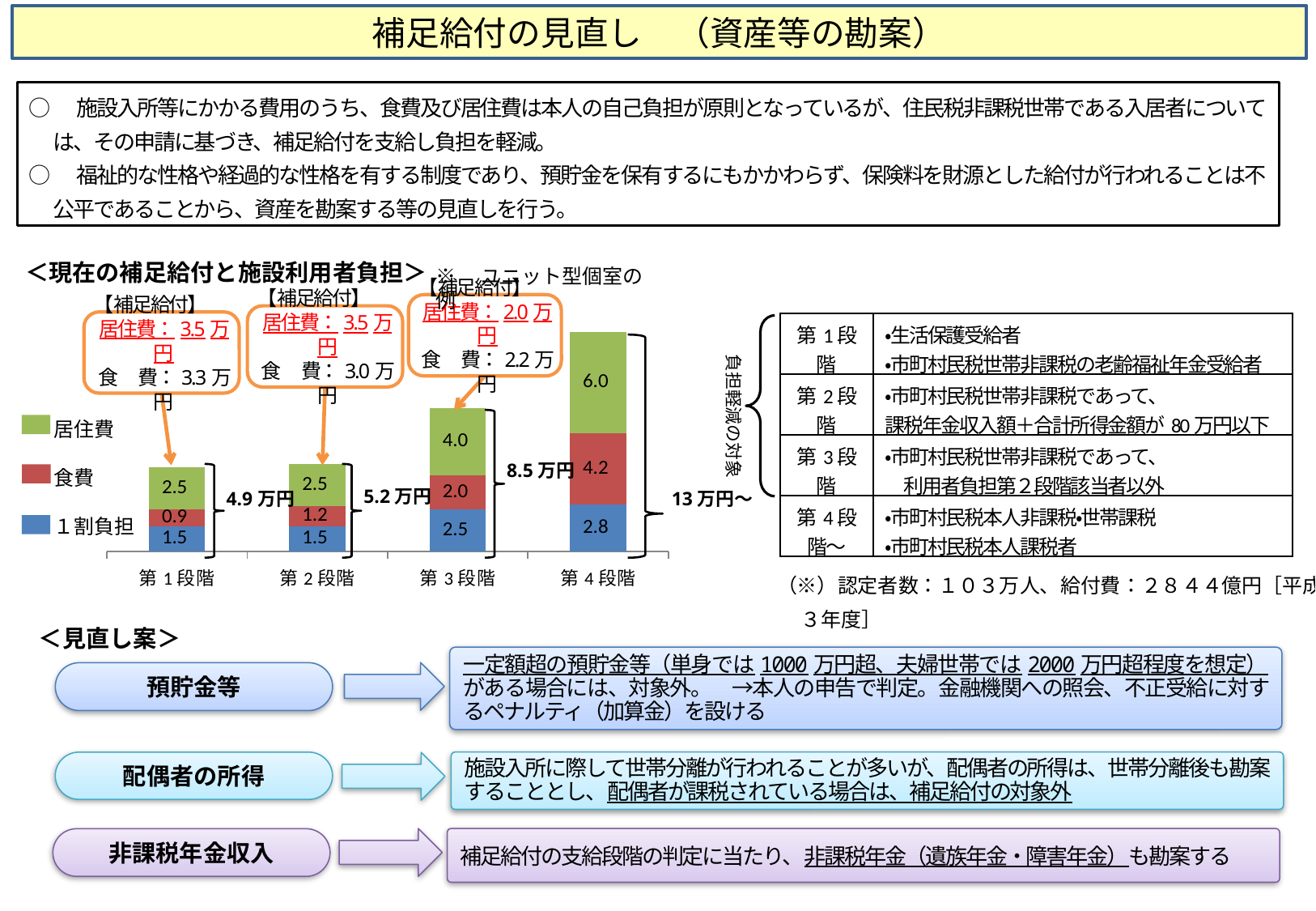
What is the 食費 value for 第１段階 in the chart? 0.9 What is the total labelled for the 第２段階 stacked bar? 5.2万円 Do the total bar heights rise or fall from 第１段階 to 第４段階? rise What is the １割負担 value for 第４段階 in the chart? 2.8 What is the 居住費 value for 第３段階 in the chart? 4.0 Which is larger, the １割負担 value for 第３段階 or for 第２段階? 第３段階 How many categories (段階) are plotted on the x axis of the chart? 4 How many series does the chart legend list? 3 What is the difference between the 食費 values for 第４段階 and 第３段階? 2.2 What type of chart is shown under ＜現在の補足給付と施設利用者負担＞? stacked bar chart Which 段階 has the highest 居住費 value in the chart? 第４段階 Which 段階 has the lowest 食費 value in the chart? 第１段階